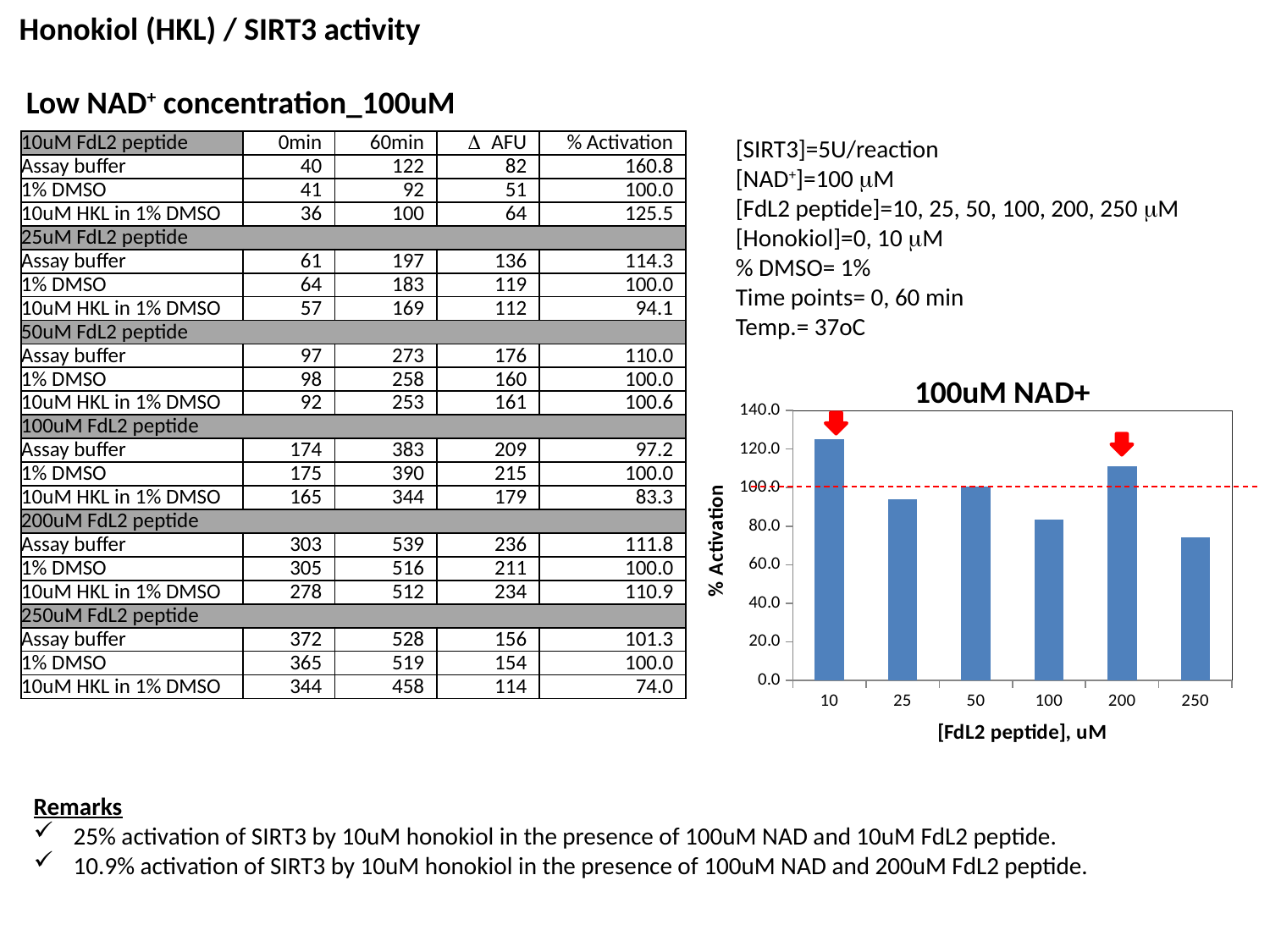
Is the % Activation for 250 uM FdL2 peptide greater or less than 80.0? less Which FdL2 peptide concentration has the highest % Activation in the chart? 10 Which has the higher % Activation in the chart, 100 uM or 200 uM FdL2 peptide? 200 Is the % Activation for 200 uM FdL2 peptide greater or less than 100.0? greater Which FdL2 peptide concentration has the lowest % Activation in the chart? 250 What is the title of the chart? 100uM NAD+ Is the % Activation for 10 uM FdL2 peptide greater or less than 120.0? greater What is the label of the y axis of the chart? % Activation How many bars (FdL2 peptide concentrations) are plotted in the chart? 6 What type of chart is shown on the slide? bar chart